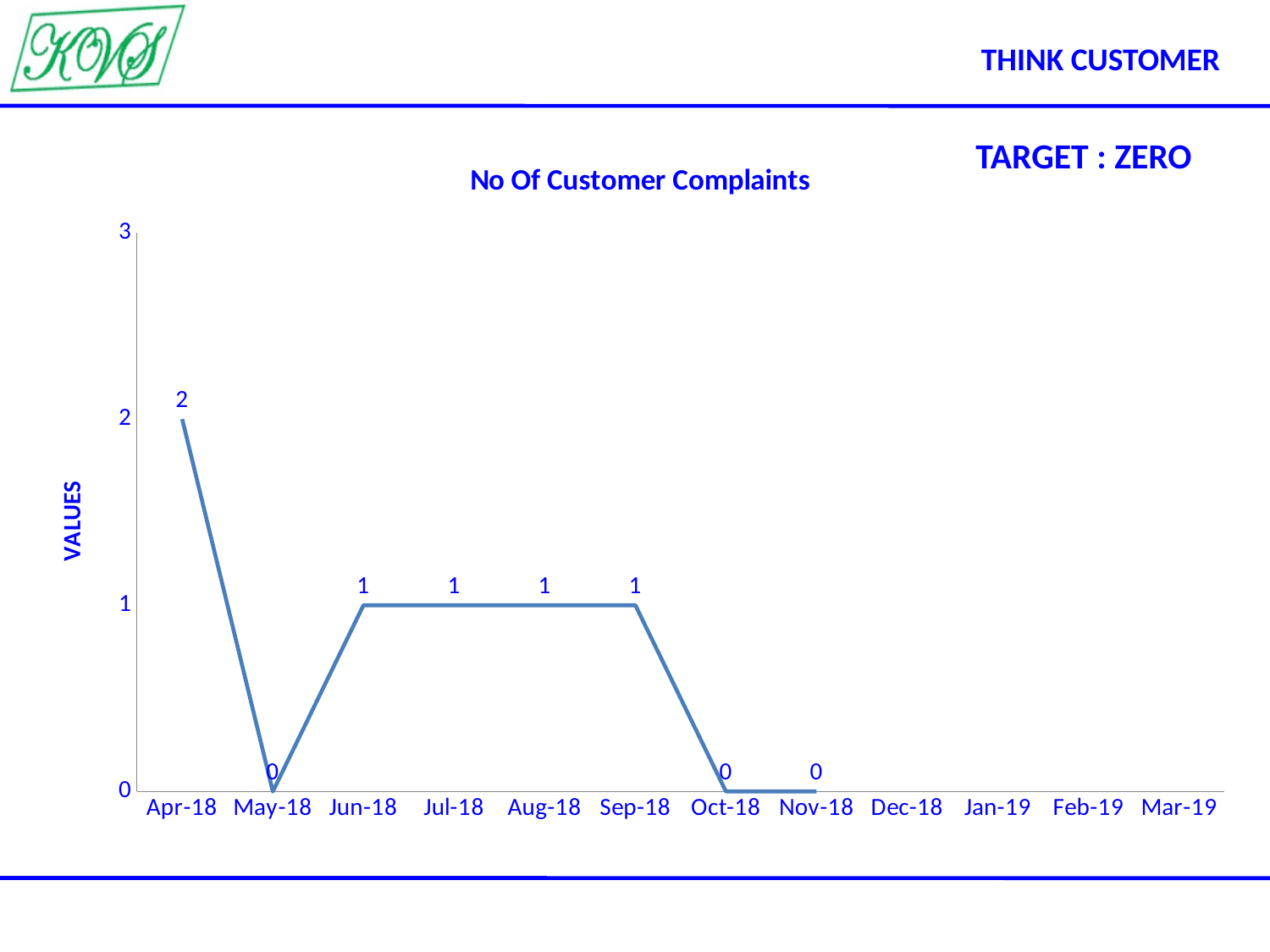
What is the number of customer complaints for Jul-18? 1 What is the number of customer complaints for Nov-18? 0 How many months have a plotted data point on the chart? 8 What is the difference between the number of complaints in Apr-18 and Jun-18? 1 What is the label of the vertical axis? VALUES What is the number of customer complaints for May-18? 0 Which month has more complaints, Sep-18 or Oct-18? Sep-18 What type of chart is shown on the slide? line chart What is the title of the chart? No Of Customer Complaints How many months are labelled on the x axis? 12 What is the number of customer complaints for Apr-18? 2 Which month has the highest number of customer complaints? Apr-18